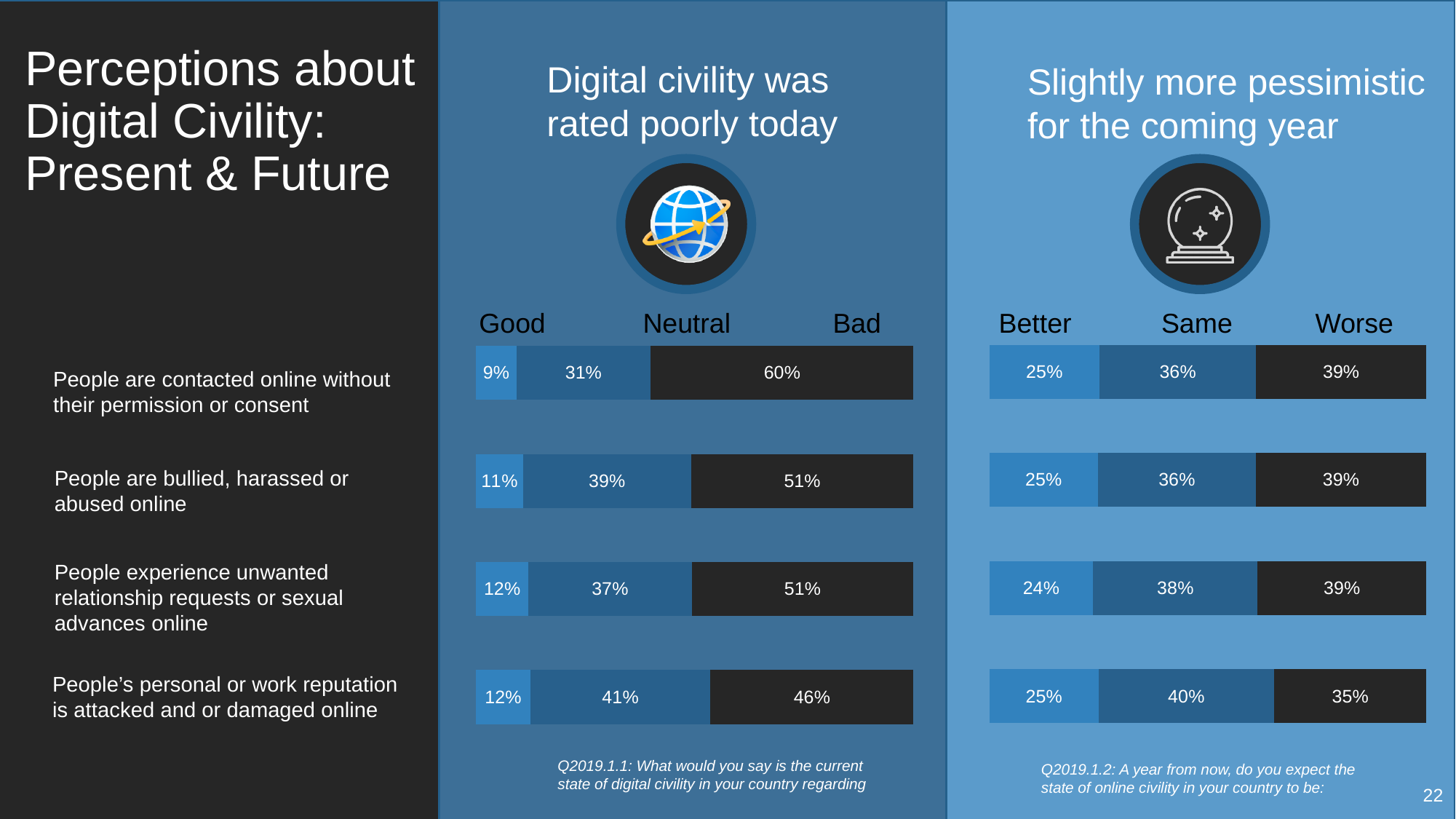
In the 'Digital civility was rated poorly today' chart, what is the difference between the Bad and Good values for 'People's personal or work reputation is attacked and or damaged online'? 34% In the 'Slightly more pessimistic for the coming year' chart, is the Worse value or the Better value larger for 'People are bullied, harassed or abused online'? Worse How many categories (rows) are shown in the 'Digital civility was rated poorly today' chart? 4 In the 'Digital civility was rated poorly today' chart, what is the Good value for 'People are bullied, harassed or abused online'? 11% In the 'Slightly more pessimistic for the coming year' chart, which category has the lowest Worse percentage? People's personal or work reputation is attacked and or damaged online In the 'Slightly more pessimistic for the coming year' chart, what is the Better value for 'People experience unwanted relationship requests or sexual advances online'? 24% What kind of chart is the 'Digital civility was rated poorly today' chart? Stacked bar chart In the 'Digital civility was rated poorly today' chart, which category has the highest Bad percentage? People are contacted online without their permission or consent How many series does the 'Slightly more pessimistic for the coming year' chart show? 3 In the 'Digital civility was rated poorly today' chart, which category has the lowest Good percentage? People are contacted online without their permission or consent In the 'Slightly more pessimistic for the coming year' chart, what is the Same value for 'People's personal or work reputation is attacked and or damaged online'? 40% In the 'Digital civility was rated poorly today' chart, what percentage rated 'People are contacted online without their permission or consent' as Bad? 60%